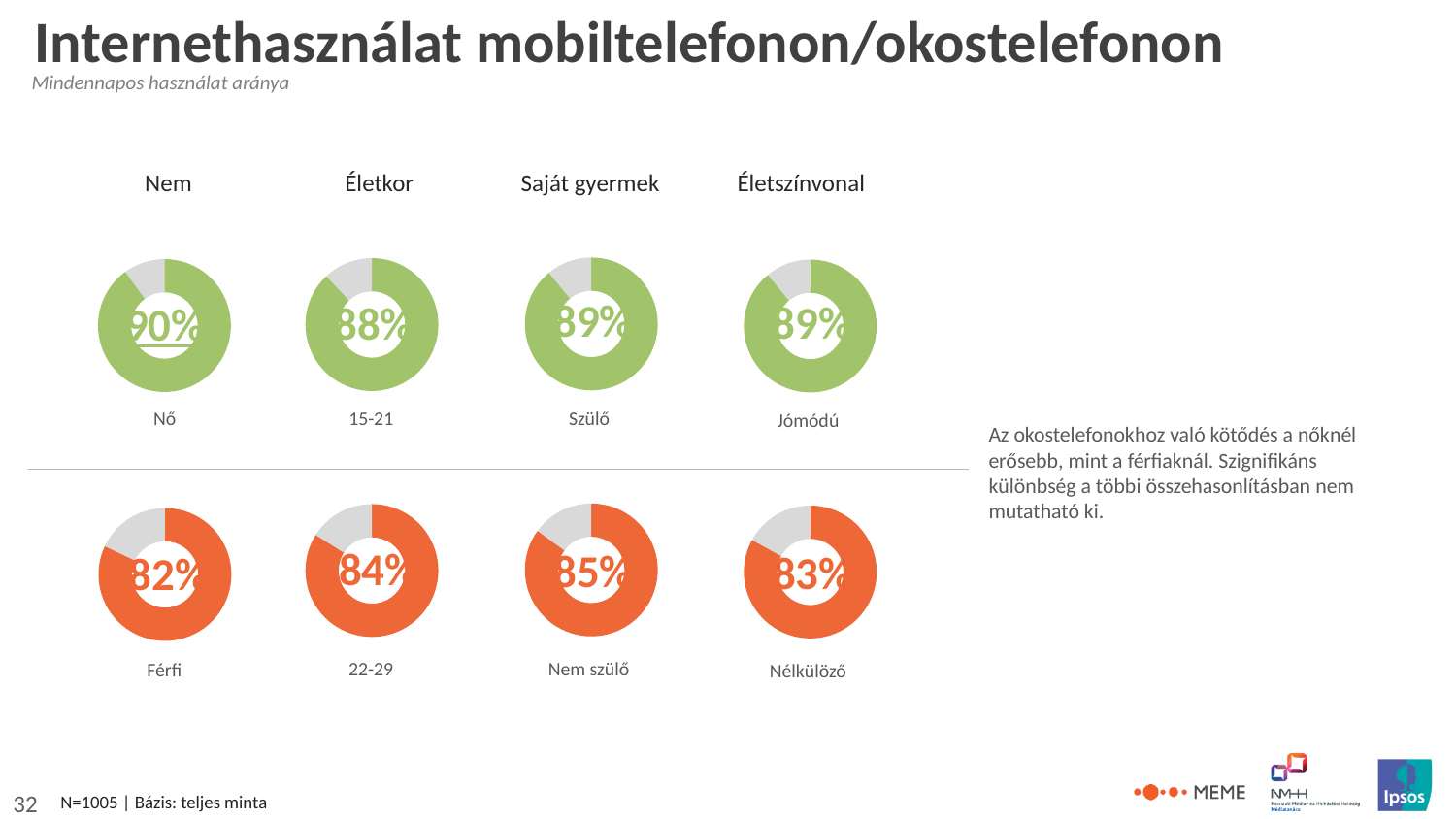
Which donut chart shows the larger value, "15-21" or "22-29"? 15-21 What value is shown in the donut chart labelled "Nem szülő"? 85% What colour are the donut charts in the bottom row (Férfi, 22-29, Nem szülő, Nélkülöző)? Orange What value is shown in the donut chart labelled "22-29"? 84% Which of the eight donut charts on the slide shows the lowest value? Férfi Which of the eight donut charts on the slide shows the highest value? Nő How many donut charts are shown on the slide? 8 What value is shown in the donut chart labelled "Nő"? 90% What value is shown in the donut chart labelled "Férfi"? 82% What is the difference between the values in the "Szülő" and "Nem szülő" donut charts? 4 percentage points What value is shown in the donut chart labelled "Nélkülöző"? 83% What is the difference between the values in the "Nő" and "Férfi" donut charts? 8 percentage points